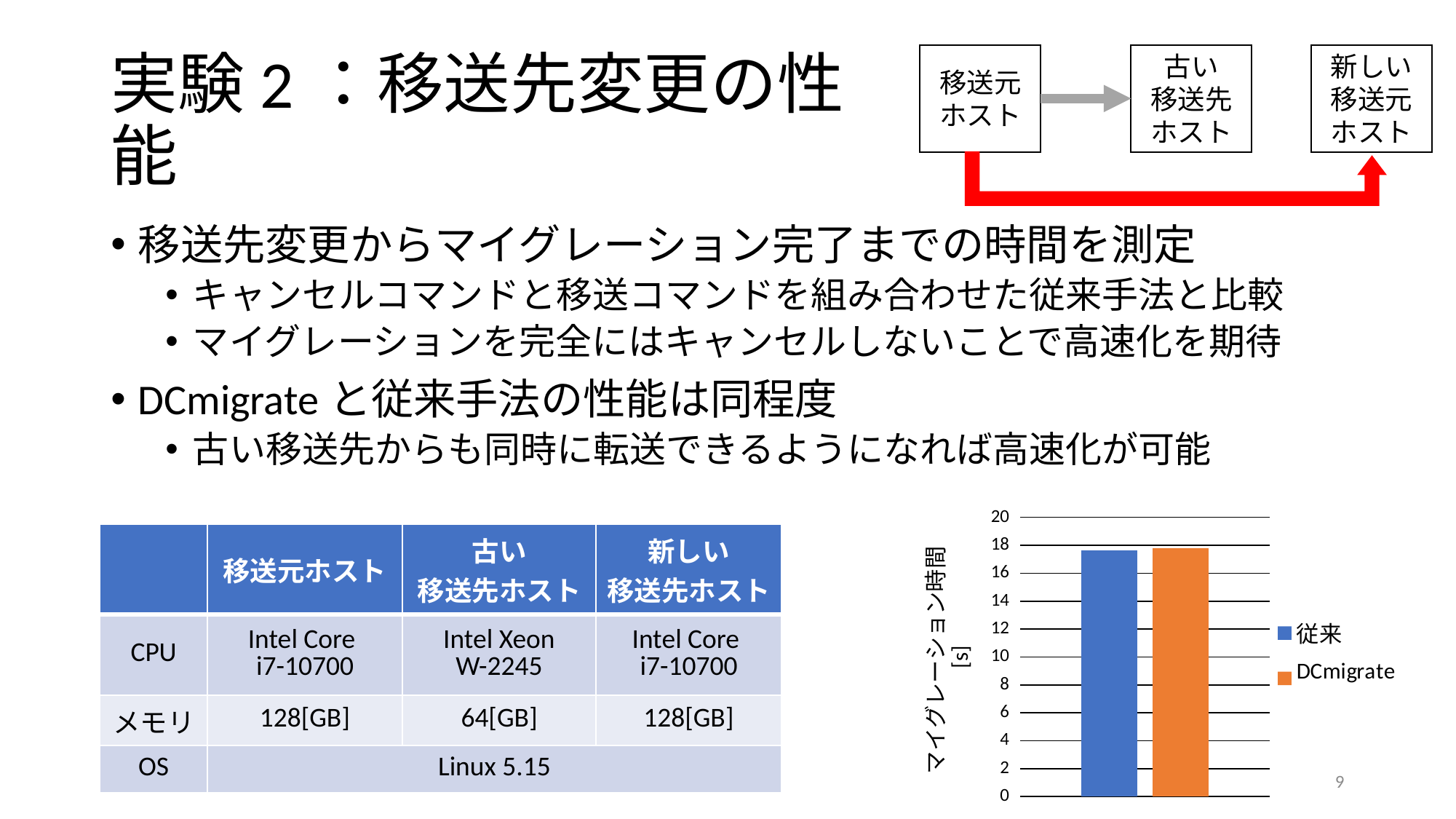
What is the label of the chart's vertical axis? マイグレーション時間 [s] What is the maximum value shown on the chart's vertical axis? 20 How many series does the chart legend list? 2 Is the value for 従来 greater or less than 16? greater Is the value for 従来 greater or less than 10? greater What kind of chart is shown on the slide? bar chart What are the two series named in the chart legend? 従来 and DCmigrate Is the value for 従来 greater or less than 18? less How many bars are plotted in the chart? 2